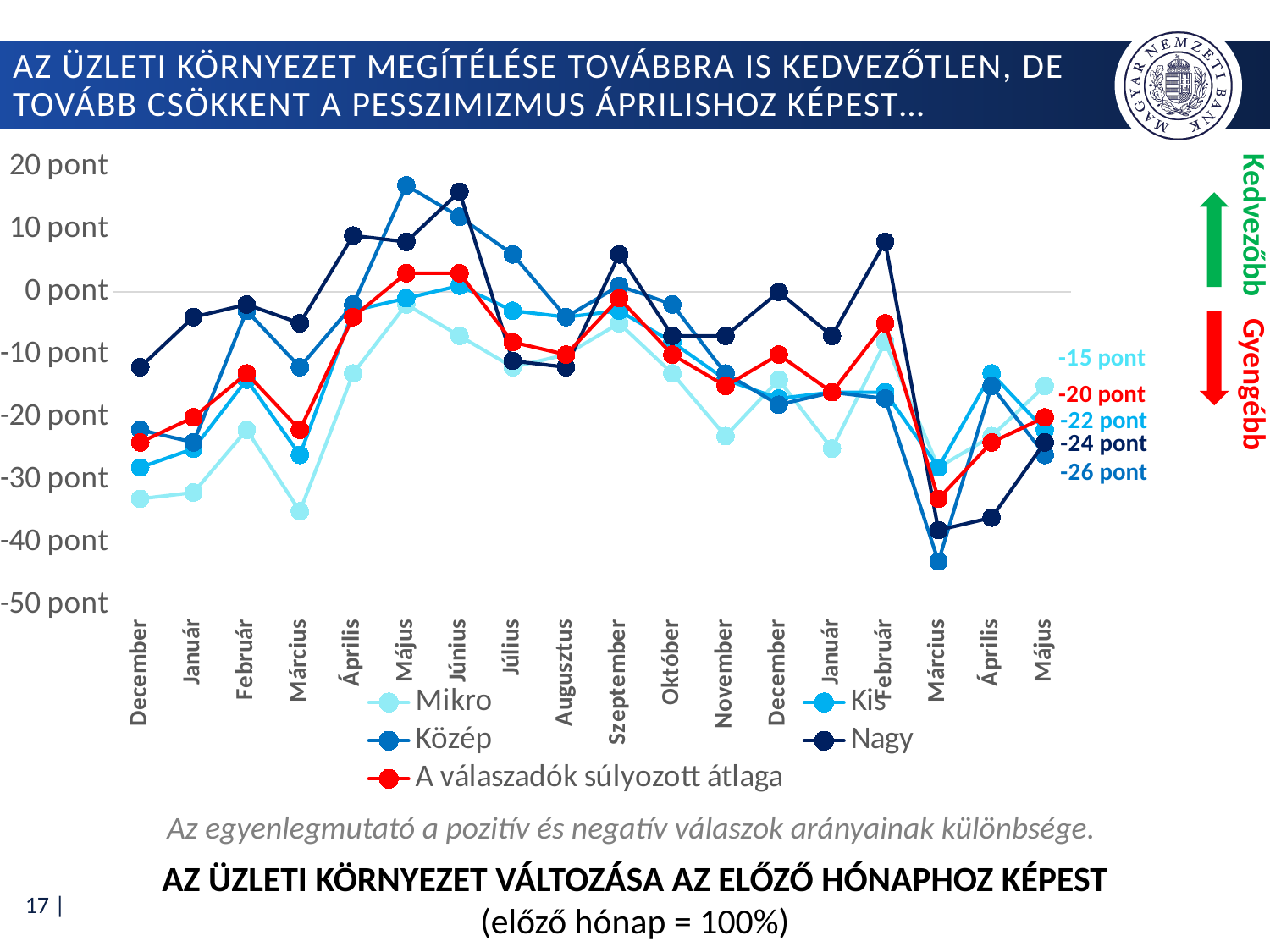
Is the value of the Közép series at the first Május point greater or less than 10 pont? greater How many series does the chart legend list? 5 How many months are plotted along the x axis of the chart? 18 What is the value of the Kis series at the final Május point, as labelled on the chart? -22 pont What type of chart is shown on the slide? line chart What is the value of 'A válaszadók súlyozott átlaga' at the final Május point, as labelled on the chart? -20 pont Is the value of the Közép series at the second Március point greater or less than -40 pont? less What is the value of the Nagy series at the final Május point, as labelled on the chart? -24 pont At the final Május point, what is the difference between the Mikro value and the Közép value? 11 pont What is the value of the Közép series at the final Május point, as labelled on the chart? -26 pont What is the value of the Mikro series at the final Május point, as labelled on the chart? -15 pont Which series has the highest value at the final Május point? Mikro